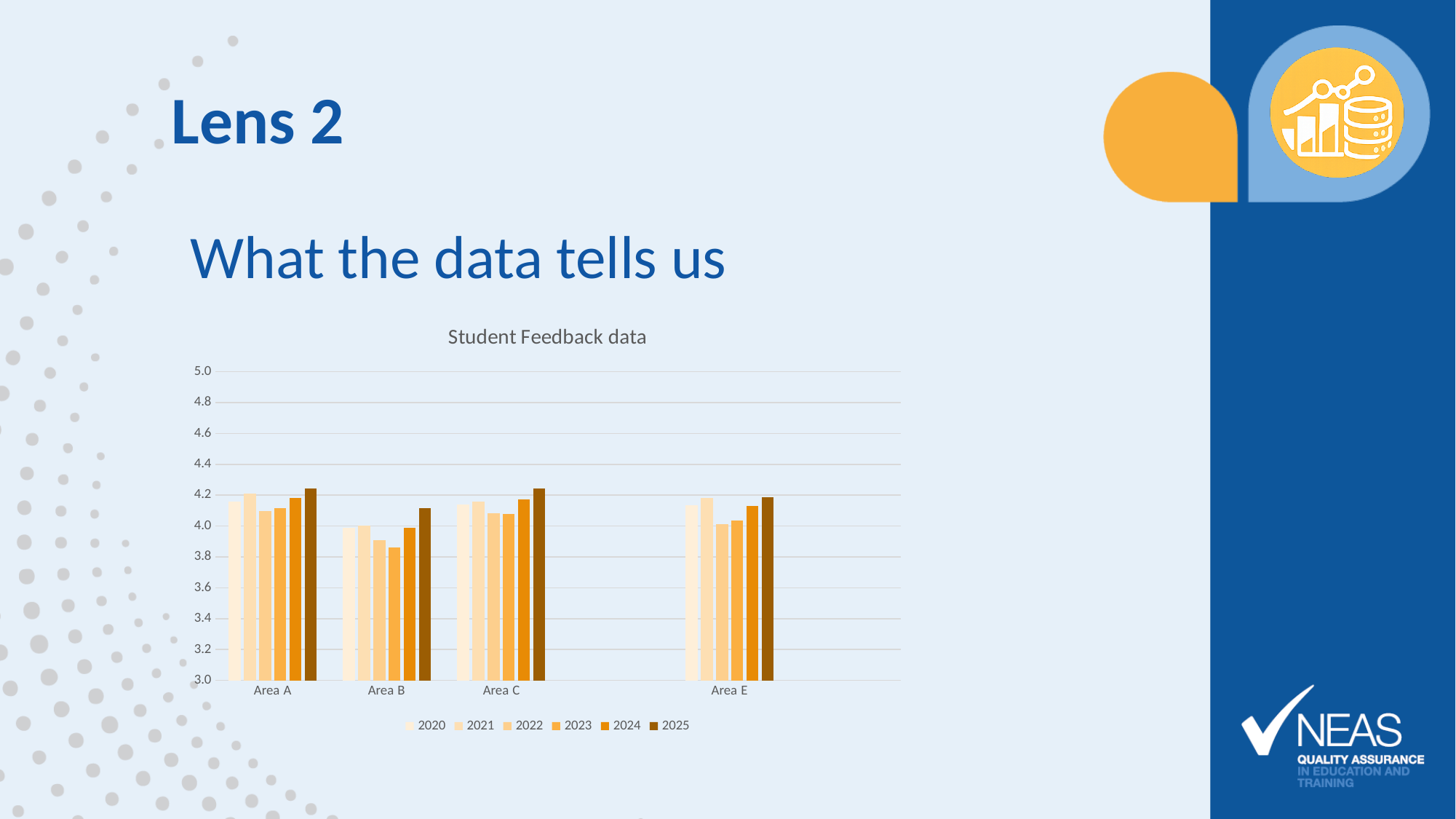
Which area has the lowest values overall across the years? Area B Is the value for 2023 in Area B greater or less than 4.0? less How many labelled categories are shown on the x axis? 4 Is the value for 2022 in Area C greater or less than 4.0? greater Which is larger, the 2025 value for Area A or the 2025 value for Area B? Area A Is the value for 2022 in Area B greater or less than 4.0? less What is the title of the chart? Student Feedback data How many series does the legend list? 6 What kind of chart is shown on the slide? Bar chart Which years are listed in the legend? 2020, 2021, 2022, 2023, 2024, 2025